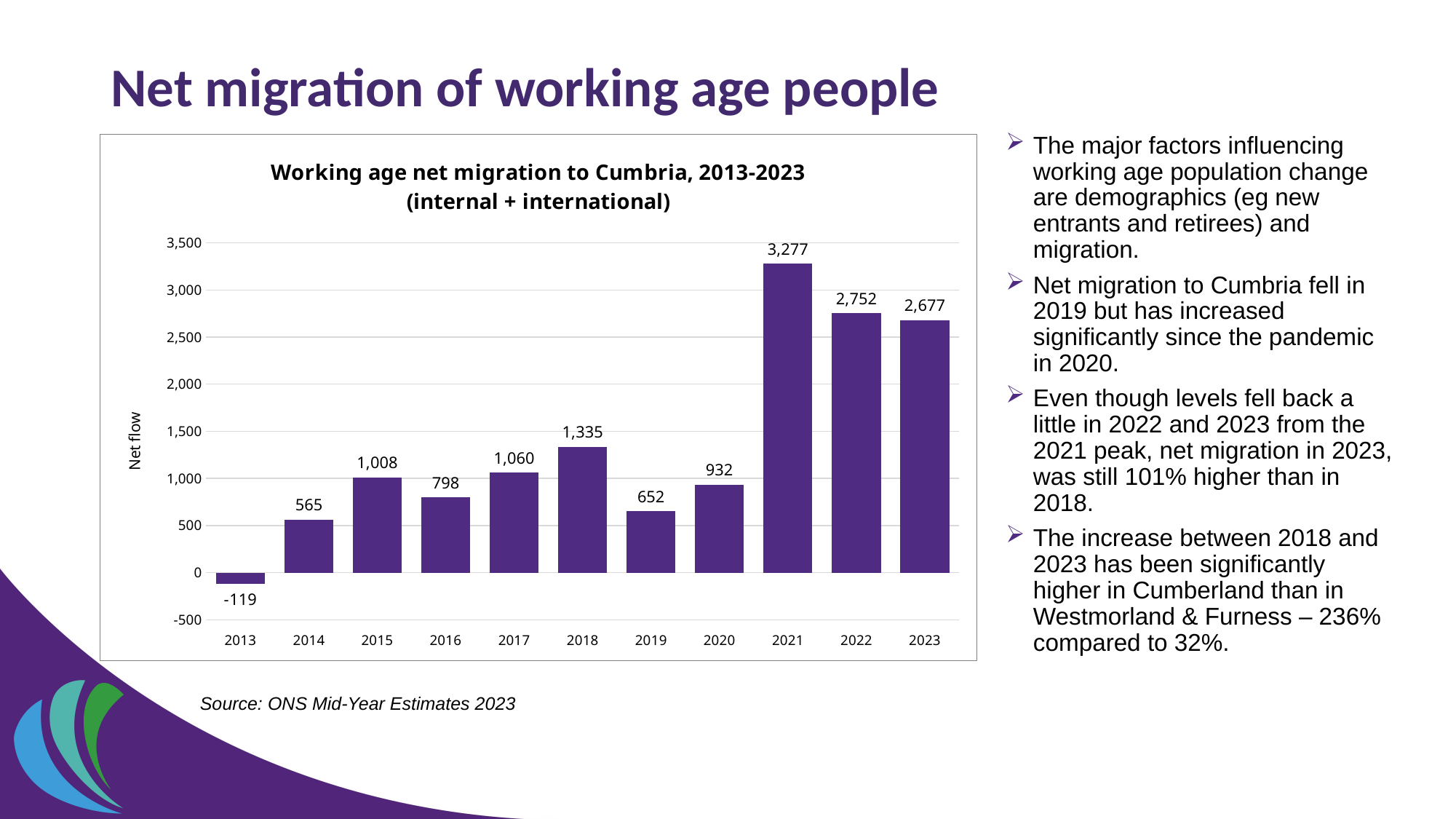
What is the working age net migration to Cumbria in 2021? 3,277 What is the working age net migration to Cumbria in 2018? 1,335 Which year has the larger net migration value, 2017 or 2020? 2017 What is the working age net migration to Cumbria in 2013? -119 What is the difference between the net migration values for 2021 and 2022? 525 Is the net migration value for 2019 greater or less than 1,000? less Which year has the highest working age net migration to Cumbria? 2021 Which year has the lowest working age net migration to Cumbria? 2013 What is the label on the vertical axis of the chart? Net flow What kind of chart is used to show working age net migration to Cumbria? Bar chart What is the difference between the net migration values for 2023 and 2018? 1,342 How many years are shown on the x axis of the chart? 11